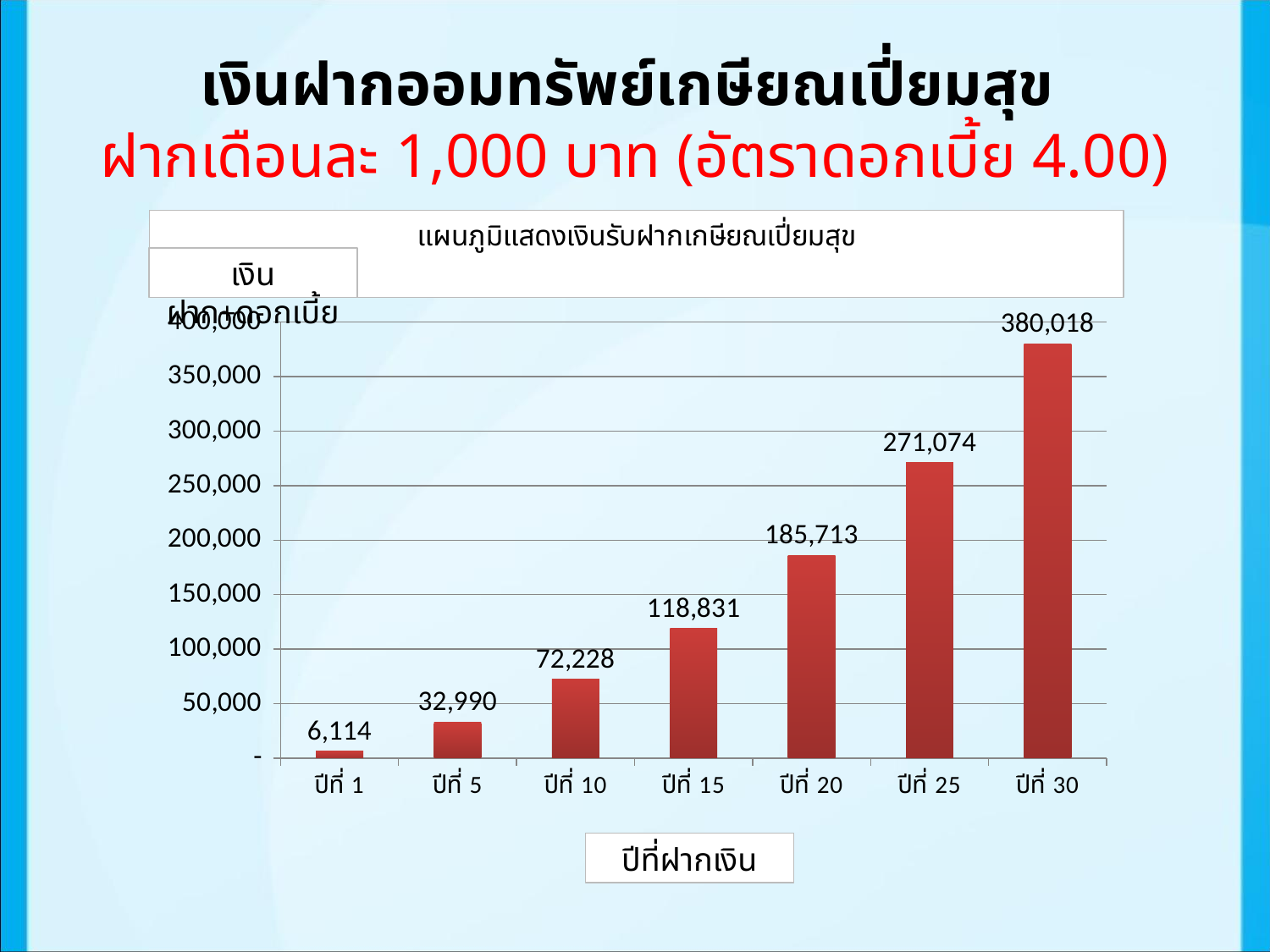
What is the difference between the values for ปีที่ 30 and ปีที่ 25? 108,944 What is the difference between the values for ปีที่ 15 and ปีที่ 5? 85,841 How many categories are shown on the x axis? 7 Which category has the highest value? ปีที่ 30 Is the value for ปีที่ 20 greater or less than 150,000? greater What is the value for ปีที่ 25? 271,074 What kind of chart is shown on the slide? bar chart What is the value for ปีที่ 1? 6,114 What is the value for ปีที่ 10? 72,228 Which is larger, the value for ปีที่ 20 or the value for ปีที่ 15? ปีที่ 20 Which category has the lowest value? ปีที่ 1 Do the values rise or fall from ปีที่ 1 to ปีที่ 30? rise